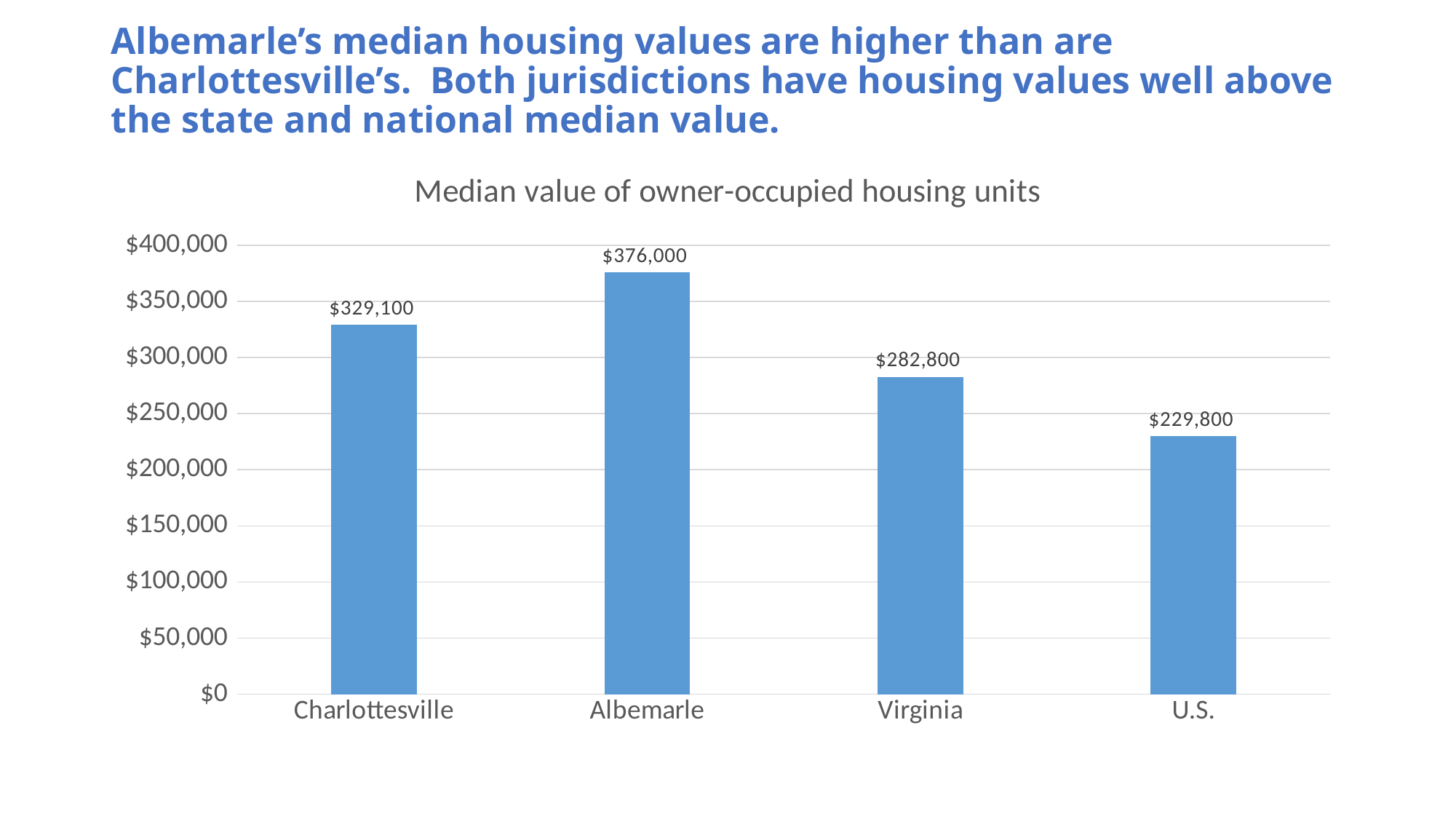
What is the median value of owner-occupied housing units for Virginia? $282,800 Is the median housing value for the U.S. greater or less than $250,000? less Which category has the highest median housing value? Albemarle How many categories are shown in the chart? 4 What type of chart is shown on the slide? Bar chart Which has a higher median housing value, Charlottesville or Virginia? Charlottesville What is the difference between Albemarle's and Charlottesville's median housing values? $46,900 Which category has the lowest median housing value? U.S. What is the difference between Virginia's and the U.S. median housing values? $53,000 What is the median value of owner-occupied housing units for the U.S.? $229,800 What is the median value of owner-occupied housing units for Charlottesville? $329,100 What is the median value of owner-occupied housing units for Albemarle? $376,000